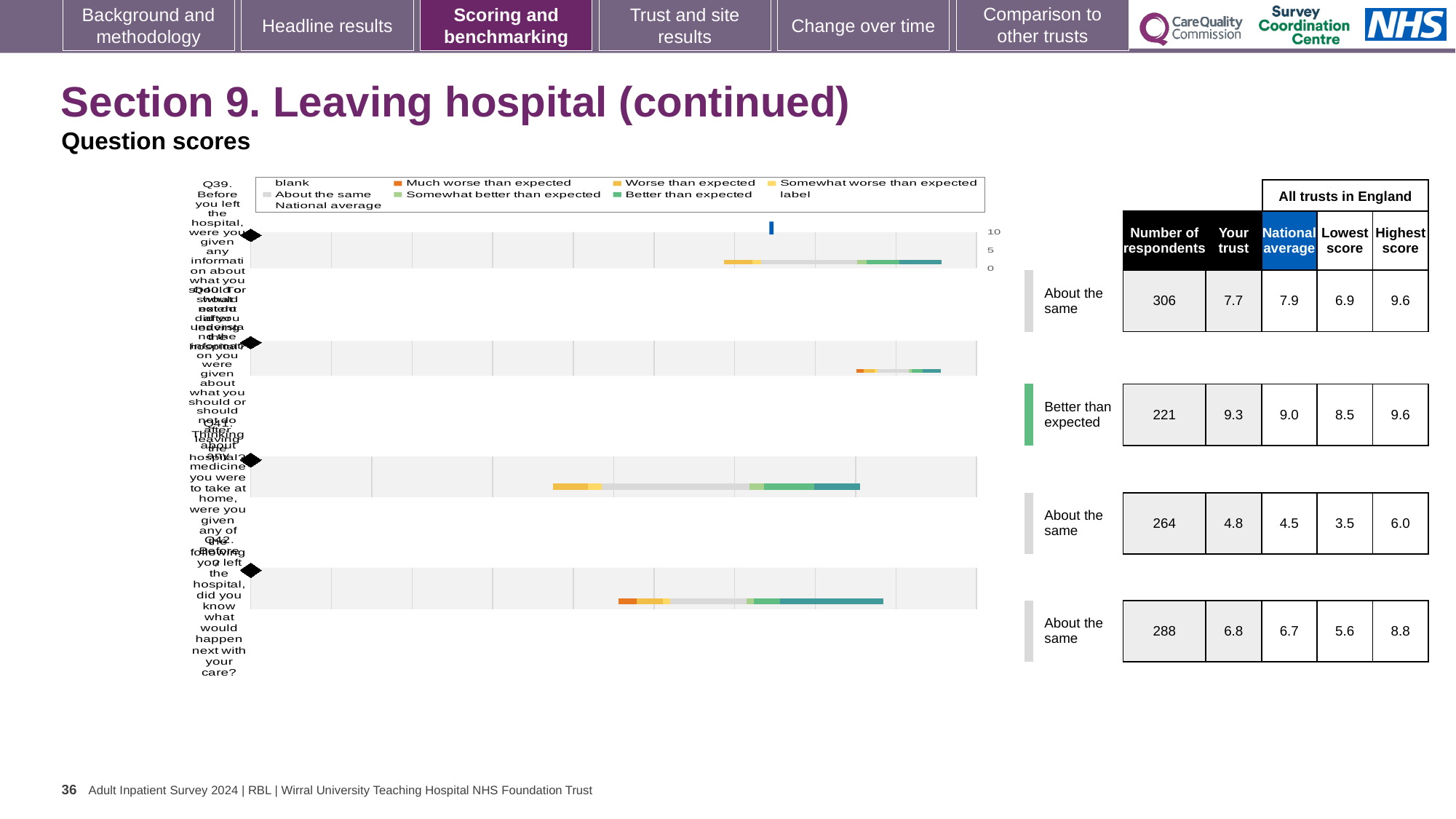
Which of the four questions has the highest 'Your trust' score in the table? Q40 How many question charts (Q39 to Q42) are shown on the slide? 4 Is the 'Your trust' score for Q40 larger or smaller than its national average? larger According to the table next to the charts, what is the 'Your trust' score for Q39? 7.7 What benchmark category is shown for Q40 (the second chart)? Better than expected Which of the four questions has the lowest 'Your trust' score in the table? Q41 According to the table next to the charts, what is the national average for Q41 (medicines to take at home)? 4.5 What is the highest score across all trusts in England for Q41 in the table? 6.0 What benchmark category is shown for Q42 (the bottom chart)? About the same What is the difference between the highest score and the lowest score for Q42 in the table? 3.2 According to the table next to the charts, how many respondents answered Q42 (did you know what would happen next with your care)? 288 What kind of chart is used to show the question scores on this slide? bar chart